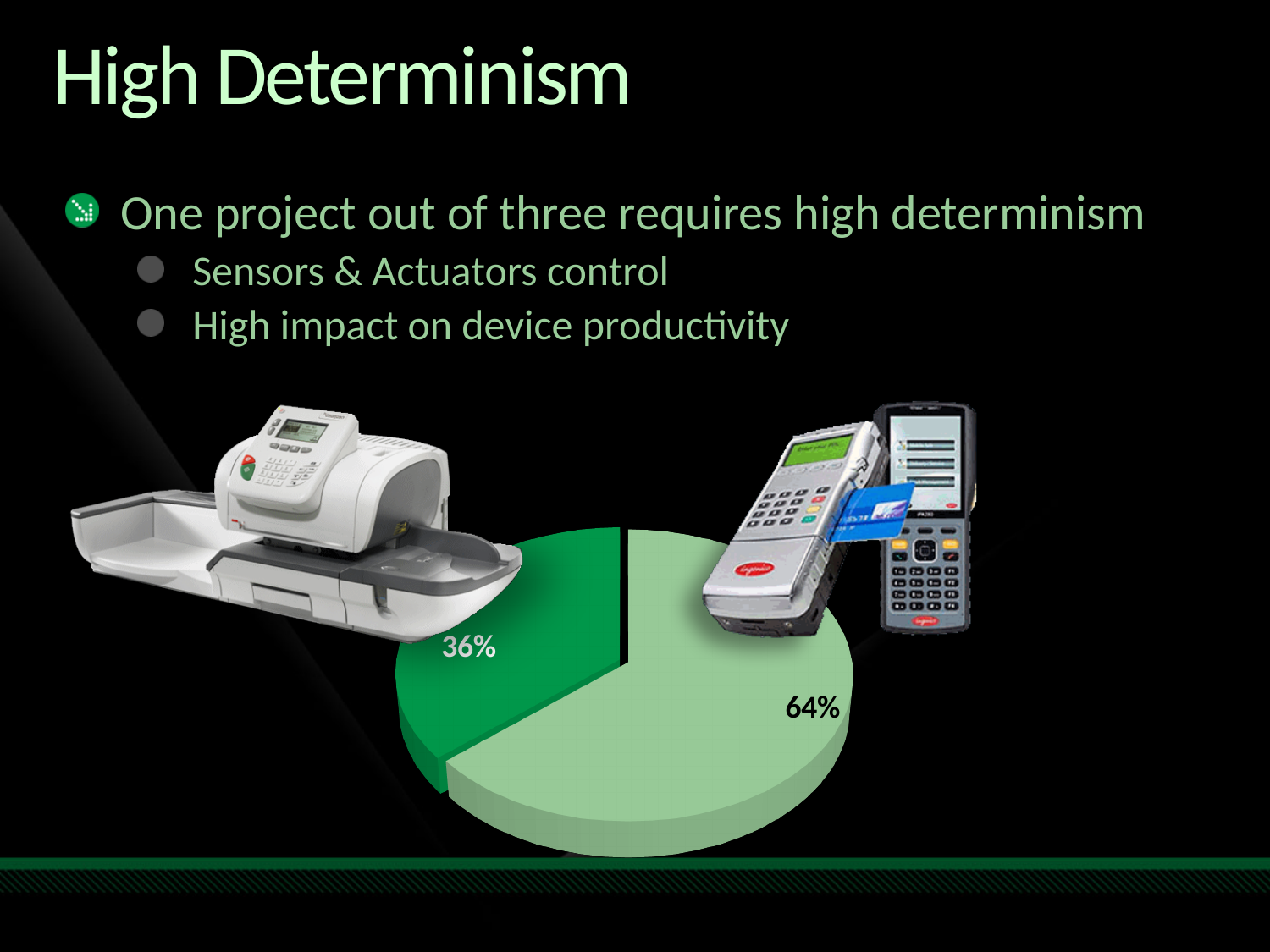
What is the value of the smallest slice of the pie chart? 36% Does the pie chart have a legend? No How many slices does the pie chart have? 2 What percentage is shown on the light green slice of the pie chart? 64% Is the value of the dark green slice greater or less than 50%? less What is the value of the largest slice of the pie chart? 64% Which slice of the pie chart is larger, the dark green one or the light green one? the light green one What do the two slices of the pie chart add up to? 100% What is the title of the slide containing the pie chart? High Determinism What is the difference in percentage points between the two slices of the pie chart? 28 What kind of chart is shown on the slide? pie chart What percentage is shown on the dark green slice of the pie chart? 36%